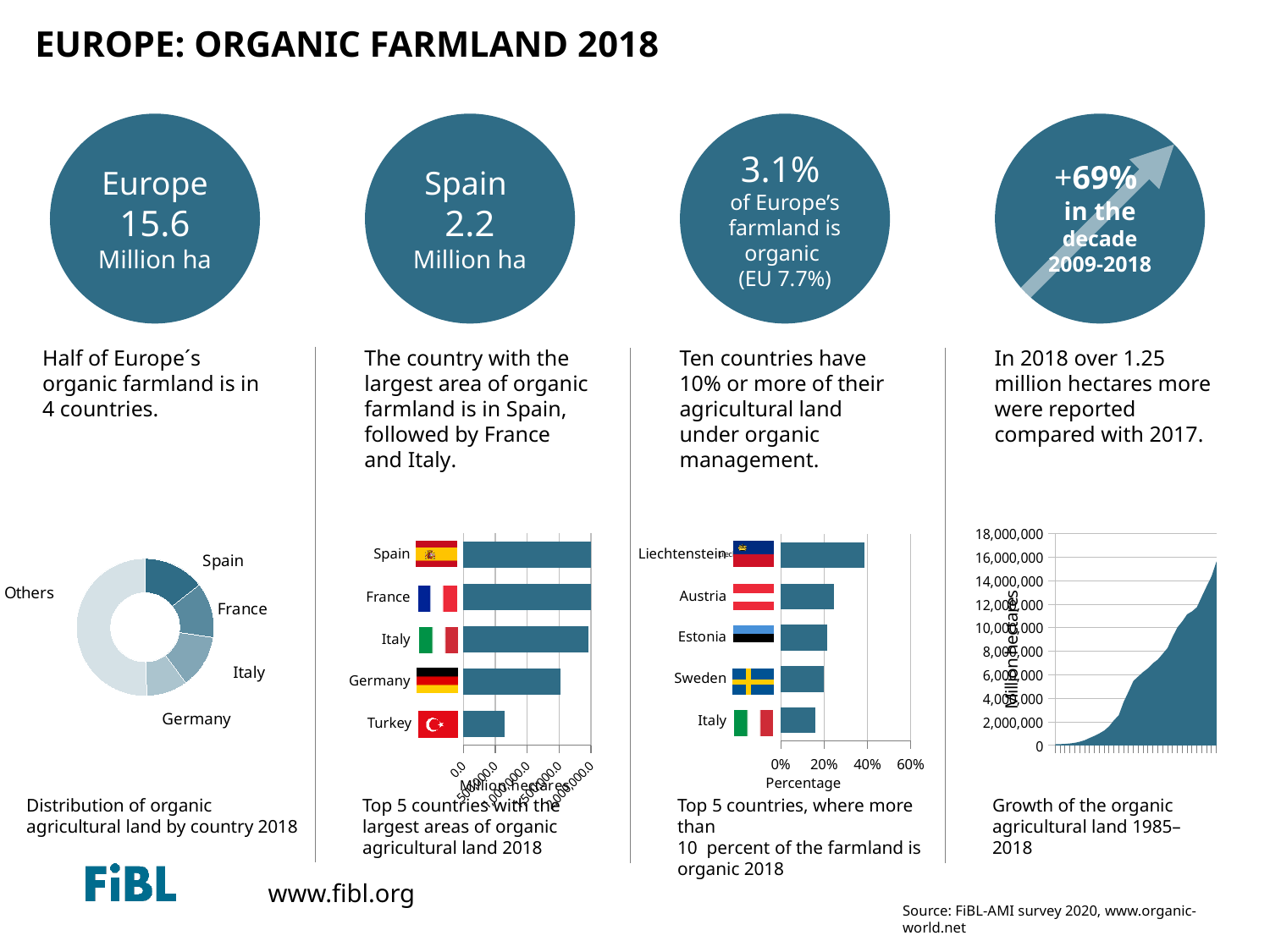
In the 'Top 5 countries with the largest areas of organic agricultural land 2018' chart, which country has the smallest bar? Turkey In the 'Top 5 countries, where more than 10 percent of the farmland is organic 2018' chart, is the value for Liechtenstein greater or less than 20%? greater In the 'Top 5 countries, where more than 10 percent of the farmland is organic 2018' chart, which country has the highest percentage? Liechtenstein What kind of chart is the 'Growth of the organic agricultural land 1985–2018' chart? Area chart In the 'Top 5 countries, where more than 10 percent of the farmland is organic 2018' chart, is the value for Italy greater or less than 20%? less In the 'Growth of the organic agricultural land 1985–2018' chart, is the final value greater or less than 14,000,000? greater What kind of chart is the 'Distribution of organic agricultural land by country 2018' chart? Pie (donut) chart What kind of chart is the 'Top 5 countries with the largest areas of organic agricultural land 2018' chart? Bar chart In the 'Top 5 countries with the largest areas of organic agricultural land 2018' chart, how many countries are shown? 5 In the 'Top 5 countries with the largest areas of organic agricultural land 2018' chart, which has the larger value, Germany or Turkey? Germany In the 'Growth of the organic agricultural land 1985–2018' chart, do the values rise or fall over time? Rise In the 'Top 5 countries, where more than 10 percent of the farmland is organic 2018' chart, which country has the lowest percentage? Italy